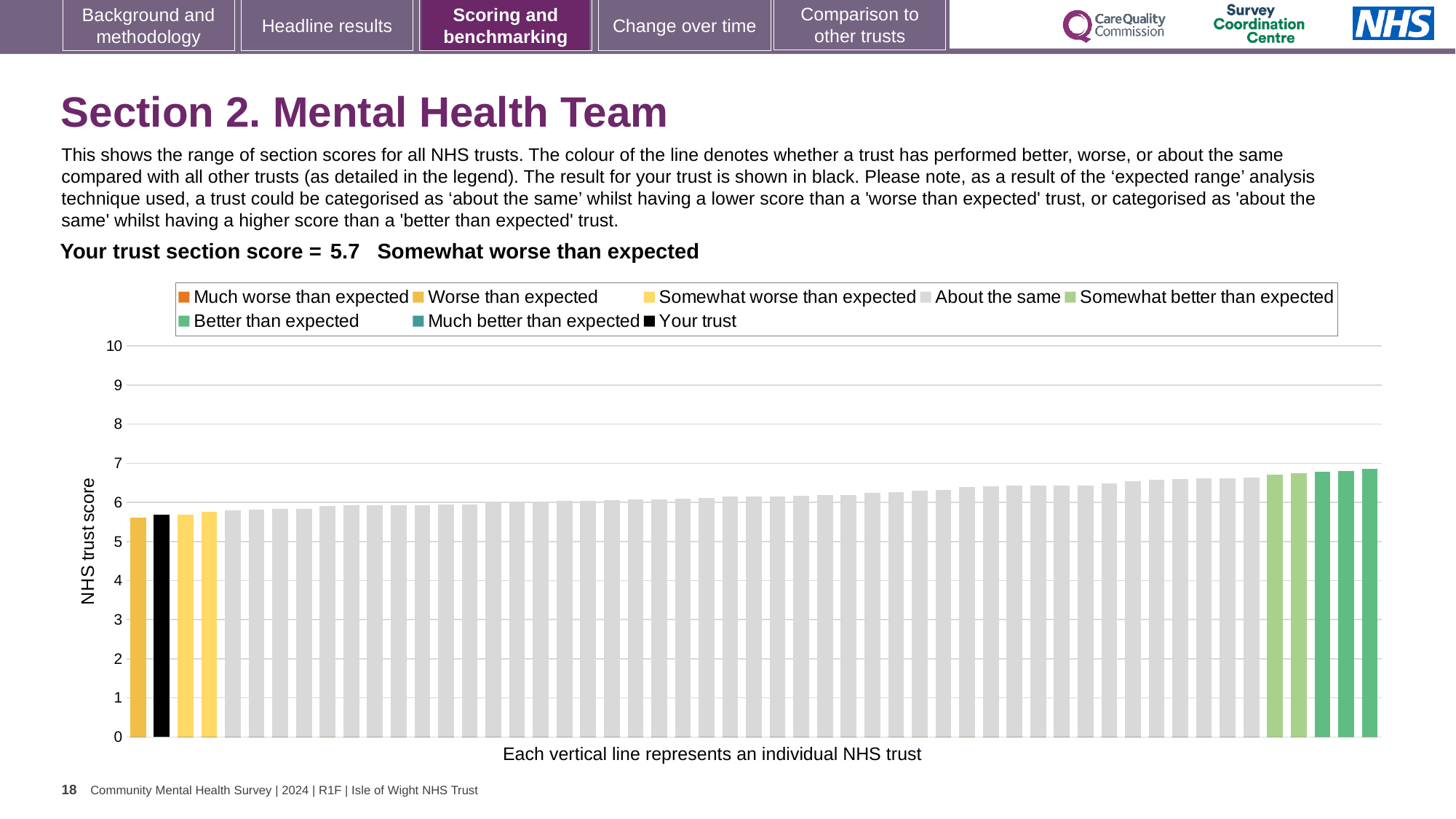
How many entries does the chart legend list? 8 Is the value for your trust (the black bar) greater or less than 5? greater What colour is used for the bar representing your trust? black What is the label on the y axis of the chart? NHS trust score Is the value of the tallest bar in the chart greater or less than 7? less How many bars are coloured as 'Somewhat better than expected' (light green)? 2 How many bars are coloured as 'Better than expected' (dark green)? 3 What is the section score for your trust shown on the slide? 5.7 Do the bar values rise or fall from left to right along the x axis? rise Is the value of the shortest bar in the chart greater or less than 6? less Which benchmarking category is your trust placed in for this section? Somewhat worse than expected What kind of chart is shown on the slide? bar chart